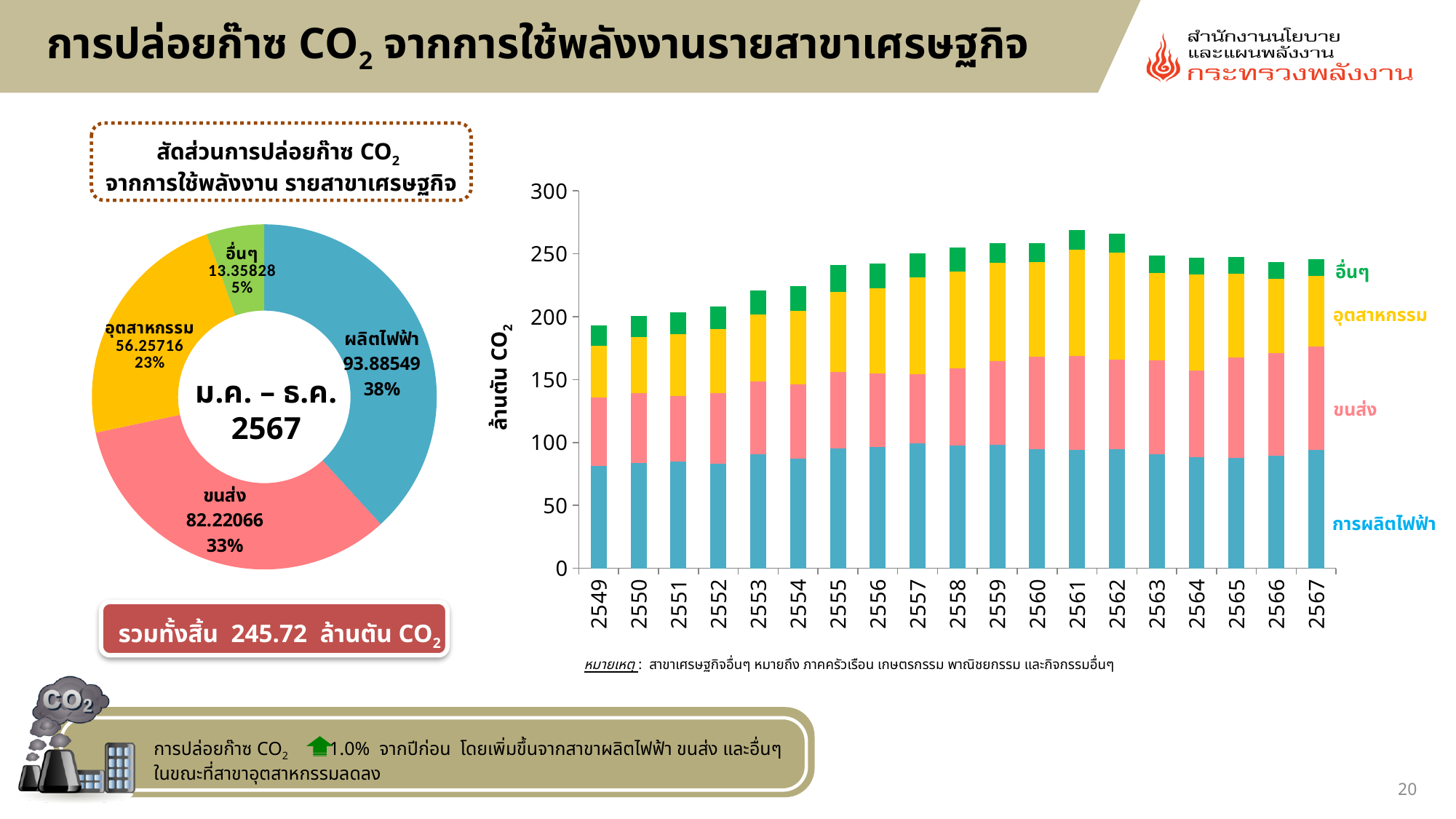
In the donut chart on the left, what is the difference between the values for ผลิตไฟฟ้า and ขนส่ง? 11.66483 How many years are shown on the x axis of the stacked bar chart on the right? 19 In the donut chart on the left, which is larger, อุตสาหกรรม or อื่นๆ? อุตสาหกรรม What kind of chart is the chart on the right of the slide? Stacked bar chart In the donut chart on the left, what is the value shown for ผลิตไฟฟ้า? 93.88549 In the stacked bar chart on the right, is the total for 2561 greater or less than 250? greater In the donut chart on the left, which sector has the smallest share? อื่นๆ In the donut chart on the left, which sector has the largest share? ผลิตไฟฟ้า In the donut chart on the left, what percentage share does ขนส่ง have? 33% How many sectors are shown in the donut chart on the left? 4 How many series are shown in the stacked bar chart on the right? 4 In the stacked bar chart on the right, do the total bar heights rise or fall from 2549 to 2561? rise